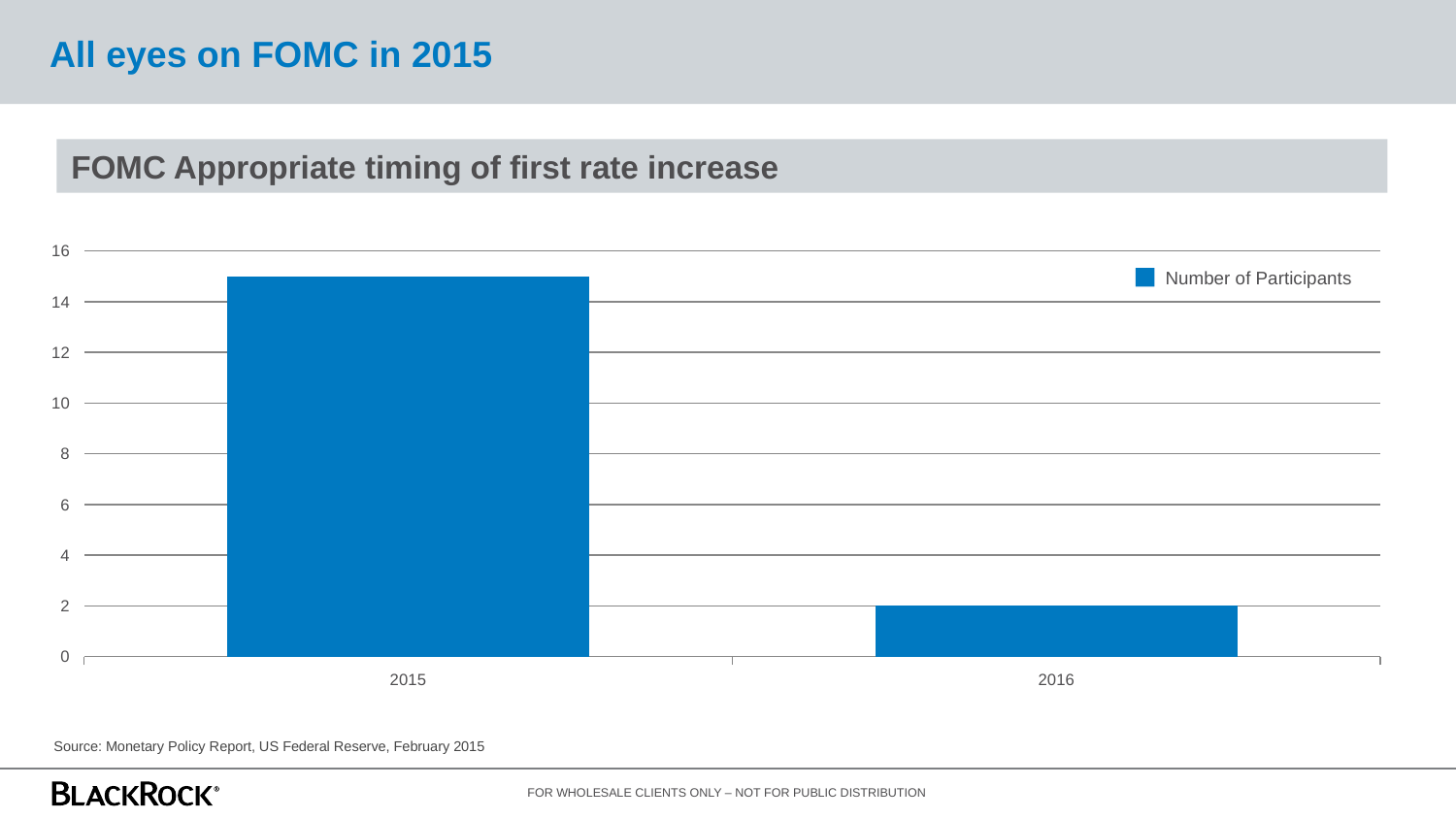
Is the number of participants for 2015 greater or less than 16? less Is the number of participants for 2015 greater or less than 14? greater Which year has the lowest number of participants? 2016 What kind of chart is shown on the slide? bar chart Is the number of participants for 2016 greater or less than 4? less What is the title of the chart? FOMC Appropriate timing of first rate increase What series name is shown in the legend? Number of Participants How many series does the legend list? 1 How many categories are shown on the x axis? 2 What is the number of participants for 2016? 2 Which is larger, the number of participants for 2015 or for 2016? 2015 Which year has the highest number of participants? 2015